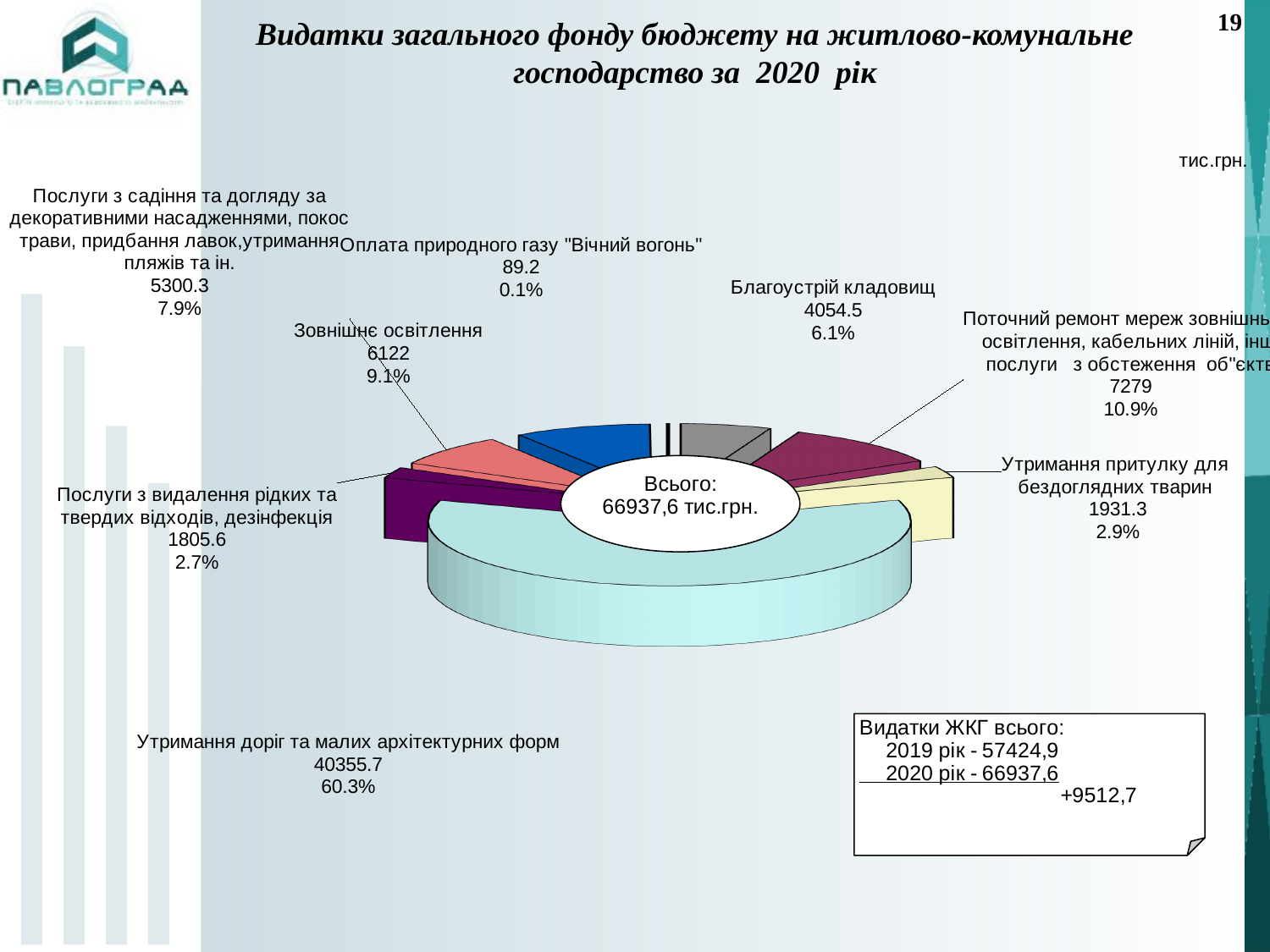
What share of the pie does "Благоустрій кладовищ" represent? 6.1% Which category has the largest slice of the pie? Утримання доріг та малих архітектурних форм How many slices does the pie chart have? 8 Which category has the smallest slice of the pie? Оплата природного газу "Вічний вогонь" What is the difference between the values for "Зовнішнє освітлення" and "Благоустрій кладовищ"? 2067.5 Which is larger: "Утримання притулку для бездоглядних тварин" or "Послуги з видалення рідких та твердих відходів, дезінфекція"? Утримання притулку для бездоглядних тварин What is the value for "Утримання доріг та малих архітектурних форм"? 40355.7 What share of the pie does "Утримання доріг та малих архітектурних форм" represent? 60.3% What is the value for "Утримання притулку для бездоглядних тварин"? 1931.3 What type of chart is shown on the slide? pie chart What total is shown in the centre of the pie chart? 66937,6 тис.грн. What is the value for "Зовнішнє освітлення"? 6122